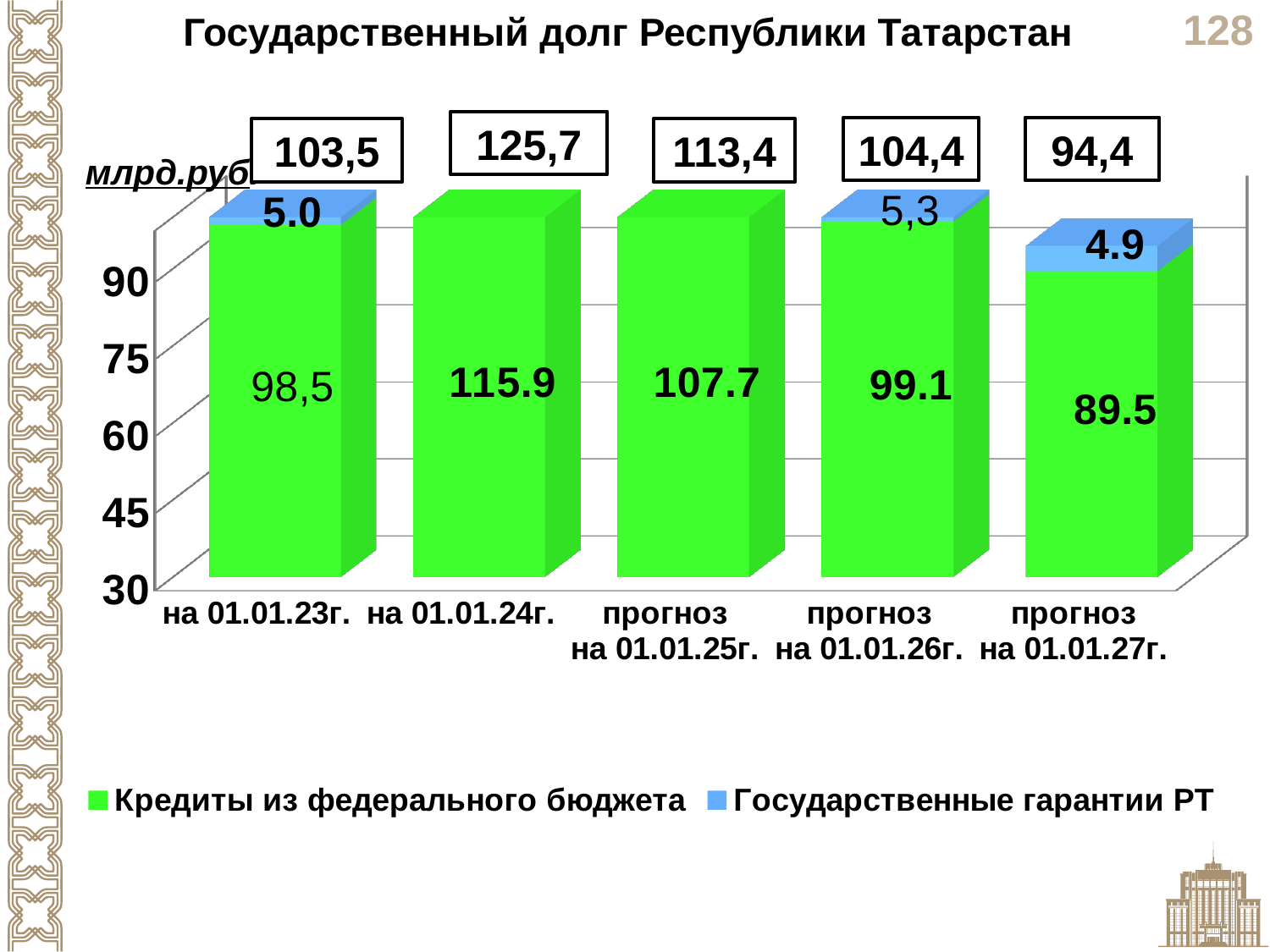
What is the value of Кредиты из федерального бюджета for на 01.01.23г.? 98,5 What kind of chart is shown on the slide? Stacked bar chart Which category has the lowest value for Кредиты из федерального бюджета? прогноз на 01.01.27г. What is the value of Кредиты из федерального бюджета for на 01.01.24г.? 115.9 What is the value of Государственные гарантии РТ for прогноз на 01.01.26г.? 5,3 Which is larger: Кредиты из федерального бюджета for прогноз на 01.01.25г. or for прогноз на 01.01.26г.? прогноз на 01.01.25г. Which category has the highest total shown above its bar? на 01.01.24г. Which colour represents Государственные гарантии РТ in the legend? Blue How many series does the legend list? 2 How many categories are shown on the x axis? 5 What is the difference between the totals shown for на 01.01.24г. and прогноз на 01.01.25г.? 12,3 What total is shown above the bar for прогноз на 01.01.27г.? 94,4